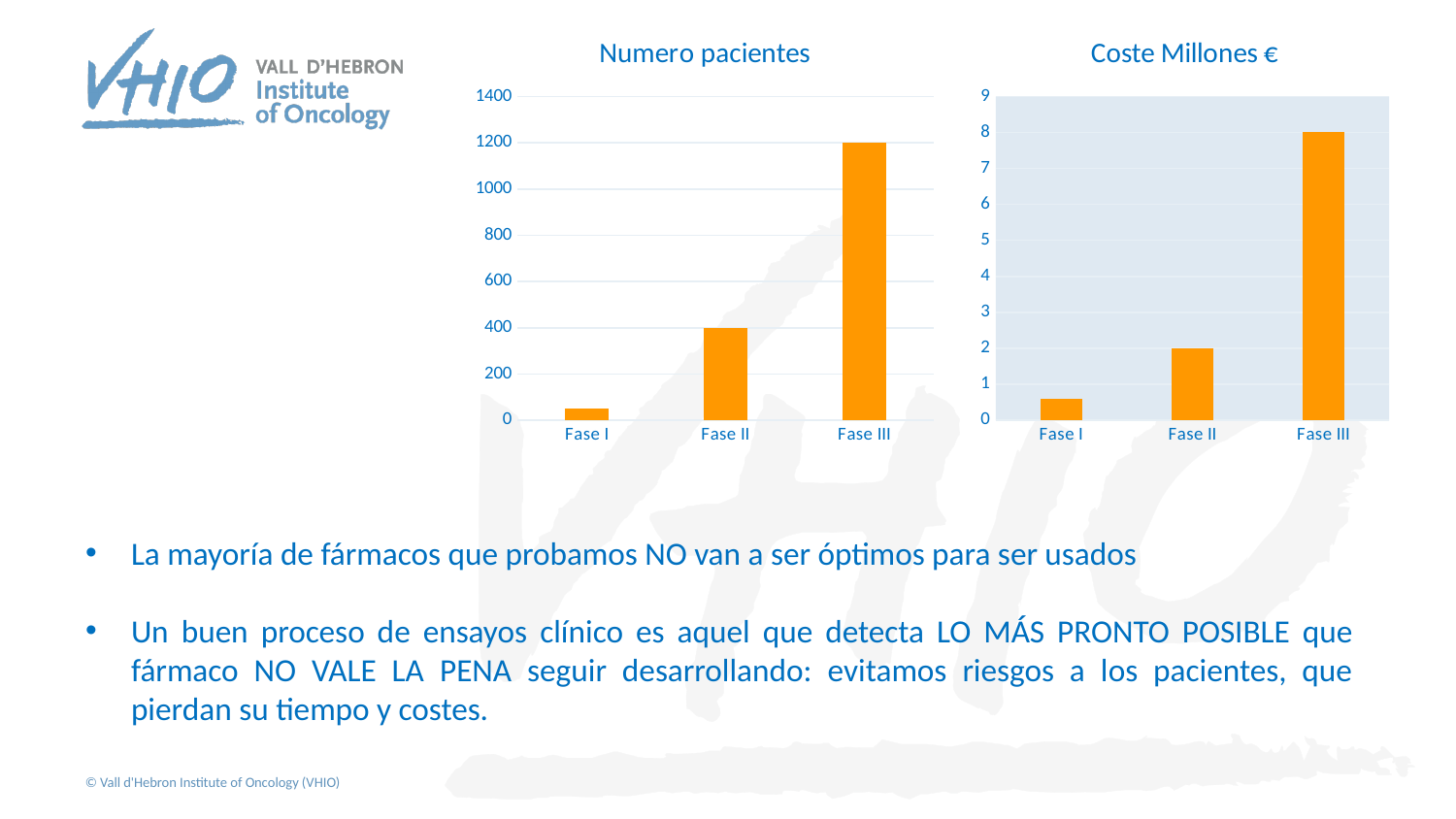
In the "Numero pacientes" chart, which phase has the highest value? Fase III In the "Coste Millones €" chart, which phase has the lowest value? Fase I In the "Numero pacientes" chart, is the value for Fase I greater or less than 200? less In the "Numero pacientes" chart, what is the difference between Fase III and Fase II? 800 What kind of chart is the "Numero pacientes" chart? Bar chart How many categories are shown on the x axis of the "Coste Millones €" chart? 3 In the "Coste Millones €" chart, which is larger, Fase II or Fase III? Fase III In the "Coste Millones €" chart, is the value for Fase I greater or less than 1? less In the "Coste Millones €" chart, what is the value for Fase II? 2 In the "Numero pacientes" chart, what is the value for Fase III? 1200 In the "Coste Millones €" chart, what is the value for Fase III? 8 In the "Numero pacientes" chart, what is the value for Fase II? 400